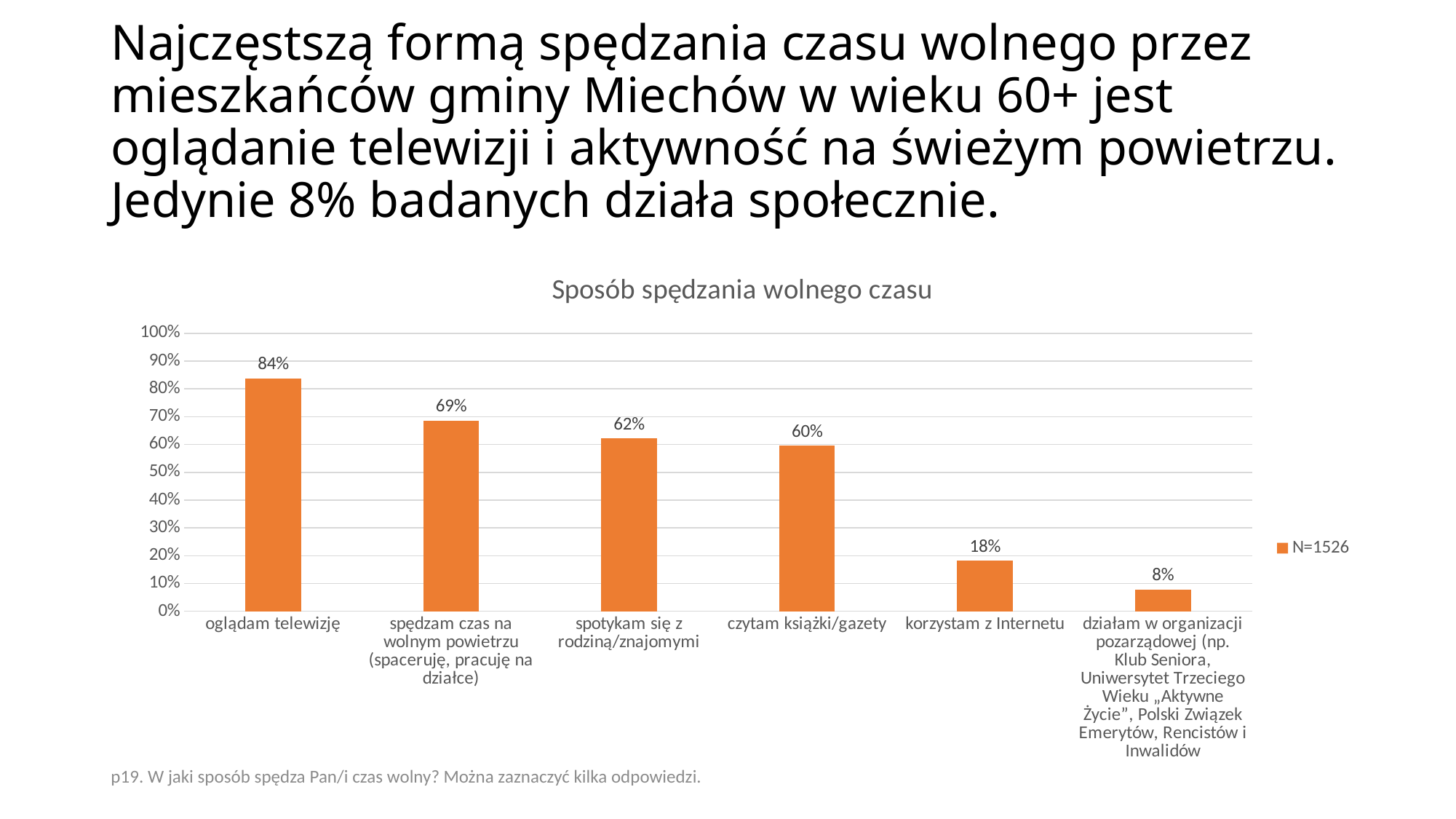
Which category has the highest value? oglądam telewizję Which is larger: the value for "spotykam się z rodziną/znajomymi" or "czytam książki/gazety"? spotykam się z rodziną/znajomymi What is the difference between the values for "oglądam telewizję" and "spędzam czas na wolnym powietrzu"? 15% What is the value for "korzystam z Internetu"? 18% Which category has the lowest value? działam w organizacji pozarządowej Is the value for "korzystam z Internetu" greater or less than 20%? less How many categories are shown on the chart? 6 What is the value for "oglądam telewizję"? 84% What kind of chart is shown on the slide? bar chart What is the title of the chart? Sposób spędzania wolnego czasu What is the value for "czytam książki/gazety"? 60% What does the legend entry say? N=1526